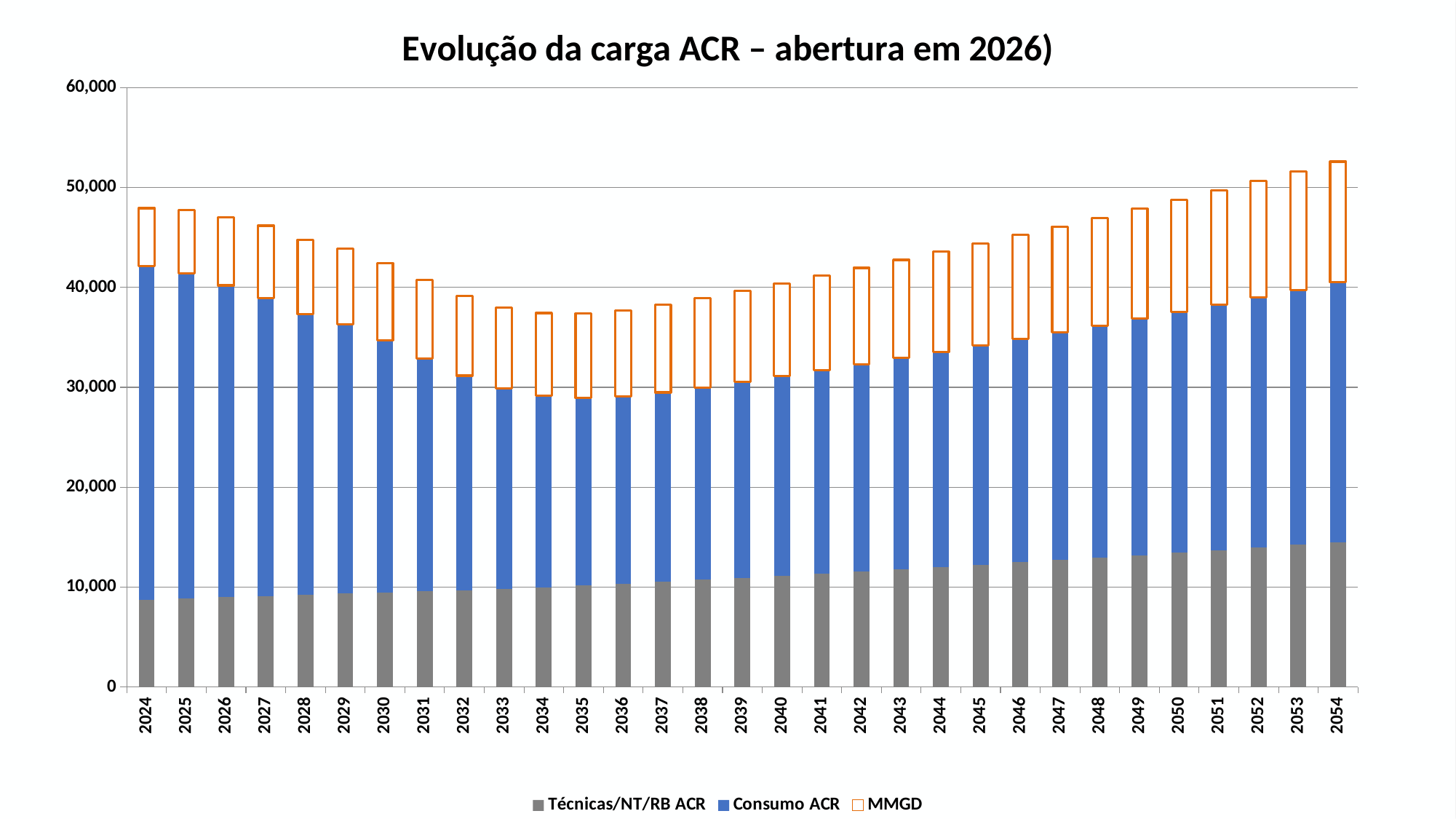
Do the total bar heights rise or fall from 2040 to 2054? rise Is the total bar height for 2054 greater or less than 50,000? greater Is the Técnicas/NT/RB ACR value for 2024 greater or less than 10,000? less Is the total bar height for 2024 greater or less than 40,000? greater How many years are shown along the x axis? 31 Which series is shown in grey in the legend? Técnicas/NT/RB ACR How many series does the legend list? 3 What kind of chart is shown on the slide? Bar chart Which has the taller total bar, 2024 or 2040? 2024 Which year has the tallest total bar? 2054